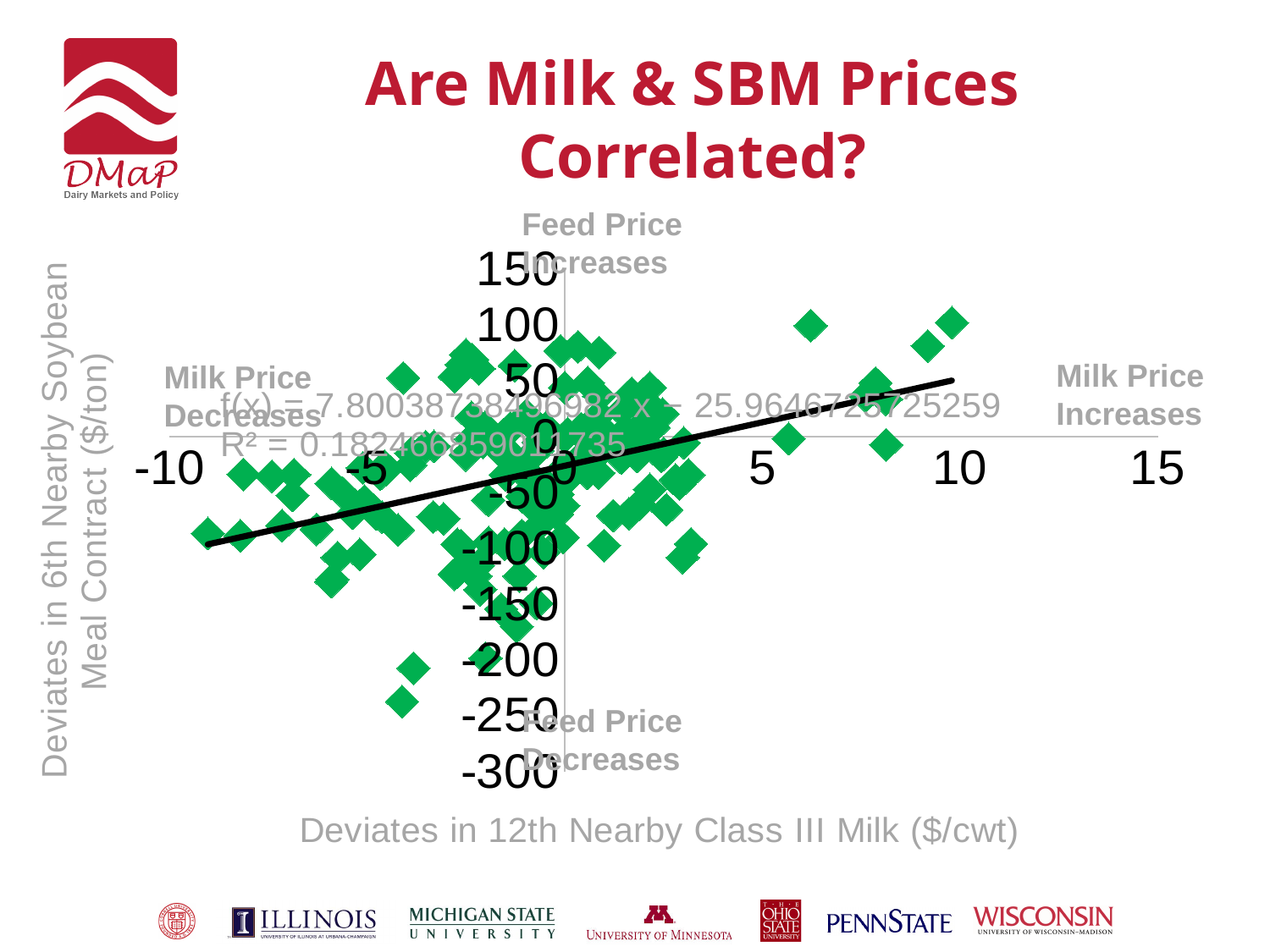
Is the y-value of the plotted point near x = 10 greater or less than 50? greater What kind of chart is shown on the slide? Scatter plot Is the y-value of the plotted point near x = -9.5 greater or less than 0? less What is the highest value shown on the y-axis of the chart? 150 What is the highest value shown on the x-axis of the chart? 15 What is the title of the chart on the slide? Are Milk & SBM Prices Correlated? Is the y-value of the lowest plotted point greater or less than -200? less Does the fitted trend line rise or fall as the x-axis values increase? Rise What is the lowest value shown on the y-axis of the chart? -300 What is the lowest value shown on the x-axis of the chart? -10 What is the x-axis title of the chart? Deviates in 12th Nearby Class III Milk ($/cwt)